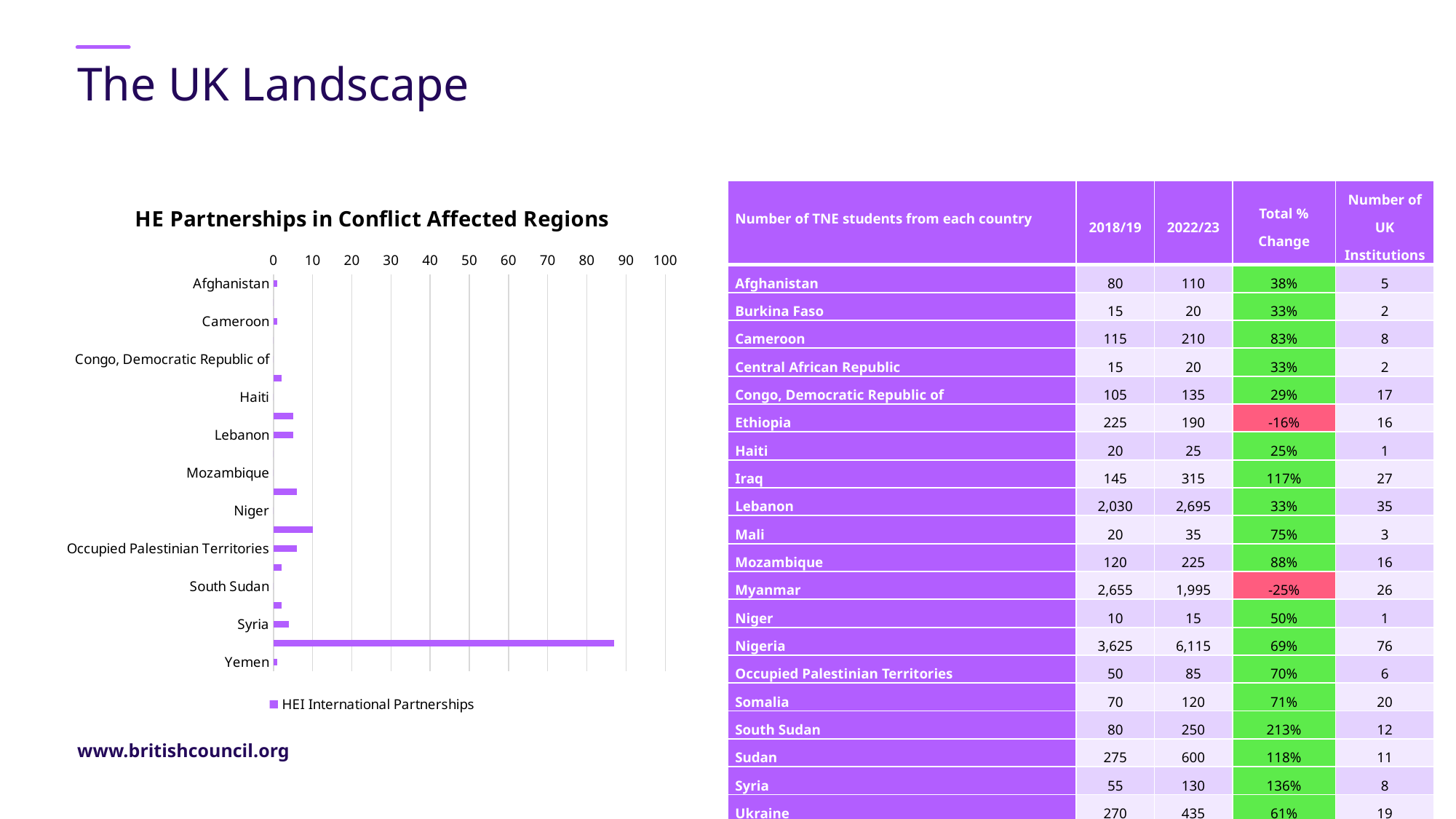
What series name is shown in the chart's legend? HEI International Partnerships Which has the larger value, Syria or Yemen? Syria Which has the larger value, Lebanon or Afghanistan? Lebanon Is the value for Syria greater or less than 10? less How many series does the chart's legend list? 1 What is the title of the chart on the slide? HE Partnerships in Conflict Affected Regions Is the value for Lebanon greater or less than 10? less What kind of chart is shown on the slide? bar chart Is the value for Occupied Palestinian Territories greater or less than 20? less Which has the larger value, Occupied Palestinian Territories or Cameroon? Occupied Palestinian Territories What is the highest value shown on the chart's axis? 100